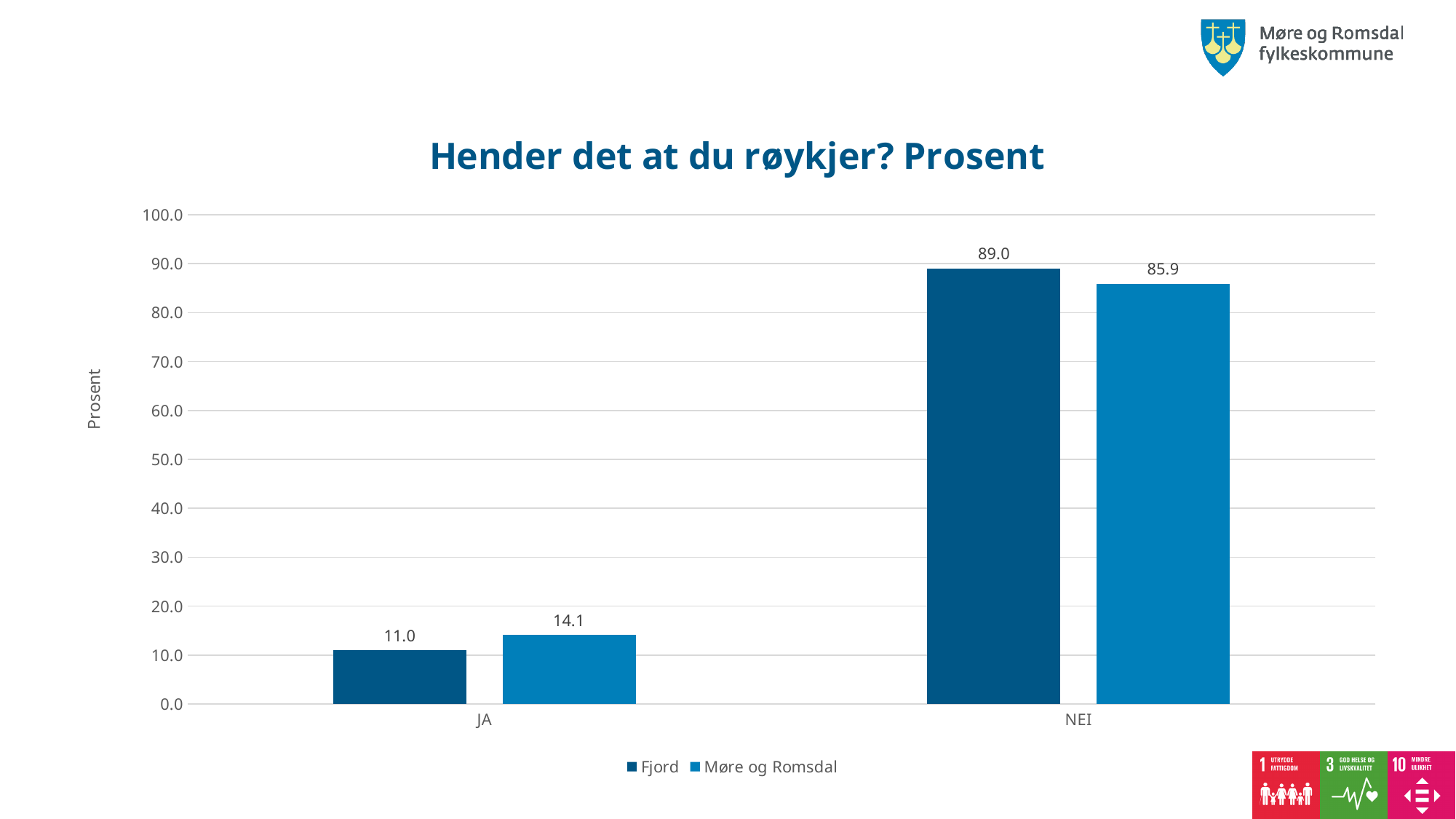
What is the value for Fjord in the NEI category? 89.0 What is the value for Fjord in the JA category? 11.0 How many series does the legend list? 2 Which category has the lowest value for Møre og Romsdal? JA What is the value for Møre og Romsdal in the NEI category? 85.9 Which category has the highest value for Fjord? NEI How many categories are shown on the x axis? 2 What is the value for Møre og Romsdal in the JA category? 14.1 What is the difference between Fjord and Møre og Romsdal in the NEI category? 3.1 What kind of chart is shown on the slide? Bar chart In the JA category, which series has the larger value, Fjord or Møre og Romsdal? Møre og Romsdal What is the title of the chart? Hender det at du røykjer? Prosent